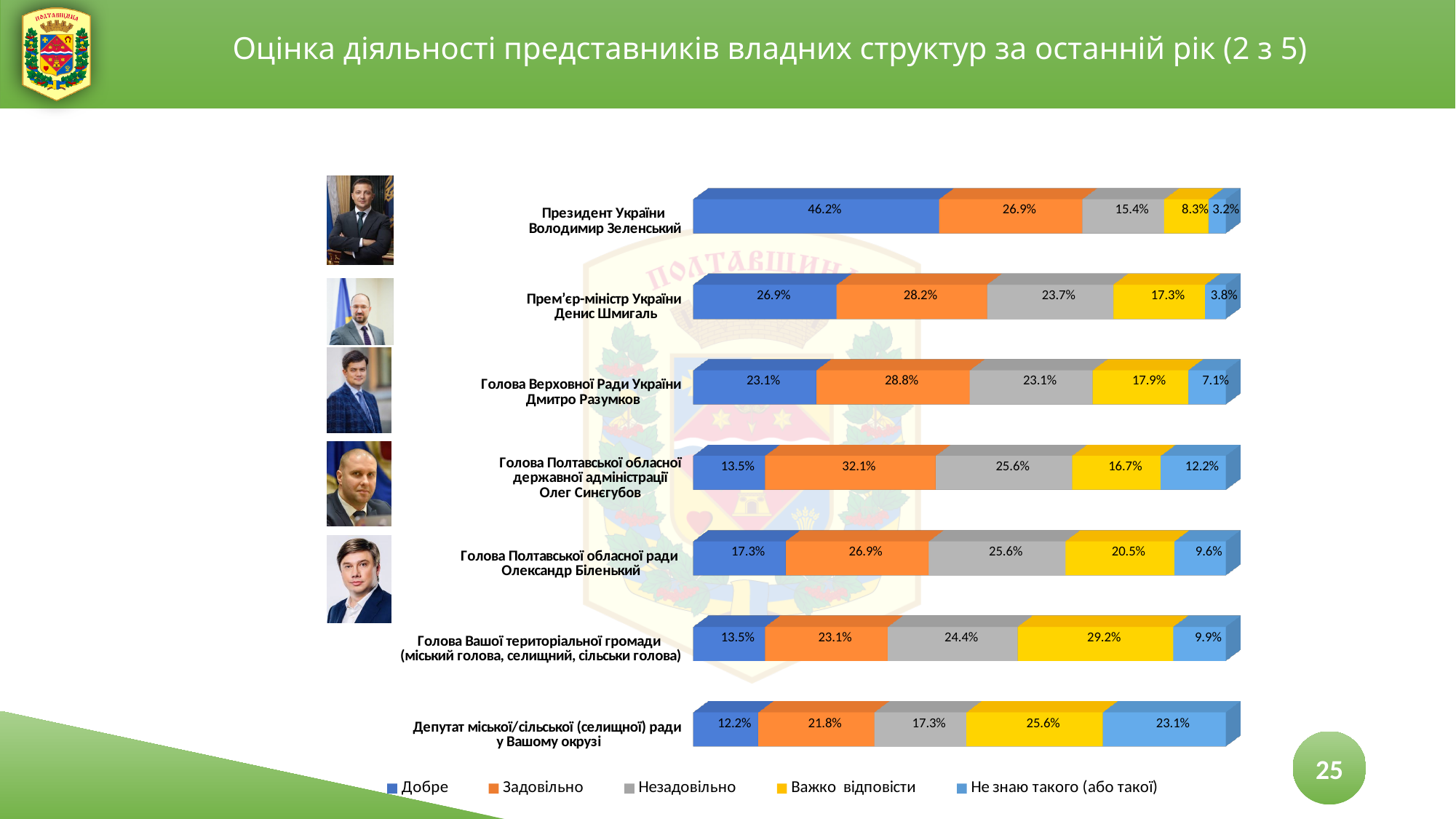
What is the 'Важко відповісти' value for Голова Вашої територіальної громади? 29.2% What is the 'Добре' value for Президент України Володимир Зеленський? 46.2% Which colour represents the 'Важко відповісти' series in the legend? Yellow Which official has the lowest 'Не знаю такого (або такої)' value? Президент України Володимир Зеленський How many series does the legend list? 5 What type of chart is shown on the slide? Stacked bar chart What is the 'Не знаю такого (або такої)' value for Депутат міської/сільської (селищної) ради у Вашому окрузі? 23.1% Which official has the highest 'Добре' value? Президент України Володимир Зеленський What is the difference between the 'Добре' values for Президент України Володимир Зеленський and Прем’єр-міністр України Денис Шмигаль? 19.3 percentage points Which is larger: the 'Задовільно' value for Голова Полтавської обласної державної адміністрації Олег Синєгубов or for Голова Полтавської обласної ради Олександр Біленький? Голова Полтавської обласної державної адміністрації Олег Синєгубов What is the 'Незадовільно' value for Прем’єр-міністр України Денис Шмигаль? 23.7% How many categories (officials) are plotted in the chart? 7